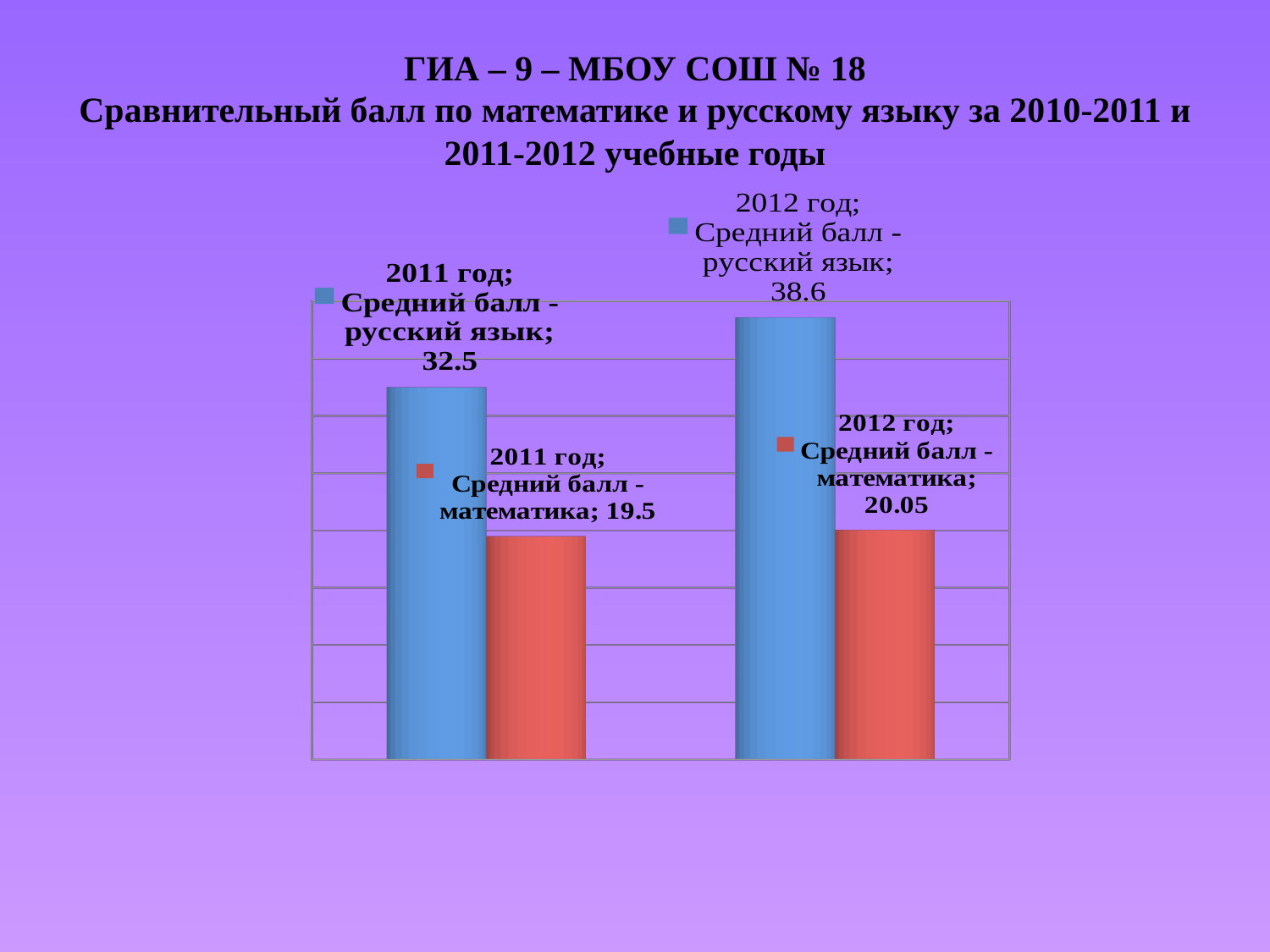
Which is larger: the mathematics score in 2011 год or in 2012 год? 2012 год (20.05) What is the average score in mathematics (Средний балл - математика) for 2011 год? 19.5 What type of chart is shown on the slide? Bar chart What is the average score in mathematics (Средний балл - математика) for 2012 год? 20.05 By how much did the average Russian language score increase from 2011 год to 2012 год? 6.1 What is the average score in Russian language (Средний балл - русский язык) for 2011 год? 32.5 Which bar has the lowest value on the chart? 2011 год; Средний балл - математика (19.5) How many bars are plotted on the chart? 4 What is the difference between the Russian language score and the mathematics score in 2011 год? 13 Which bar has the highest value on the chart? 2012 год; Средний балл - русский язык (38.6) What is the average score in Russian language (Средний балл - русский язык) for 2012 год? 38.6 Does the average Russian language score rise or fall from 2011 год to 2012 год? Rise